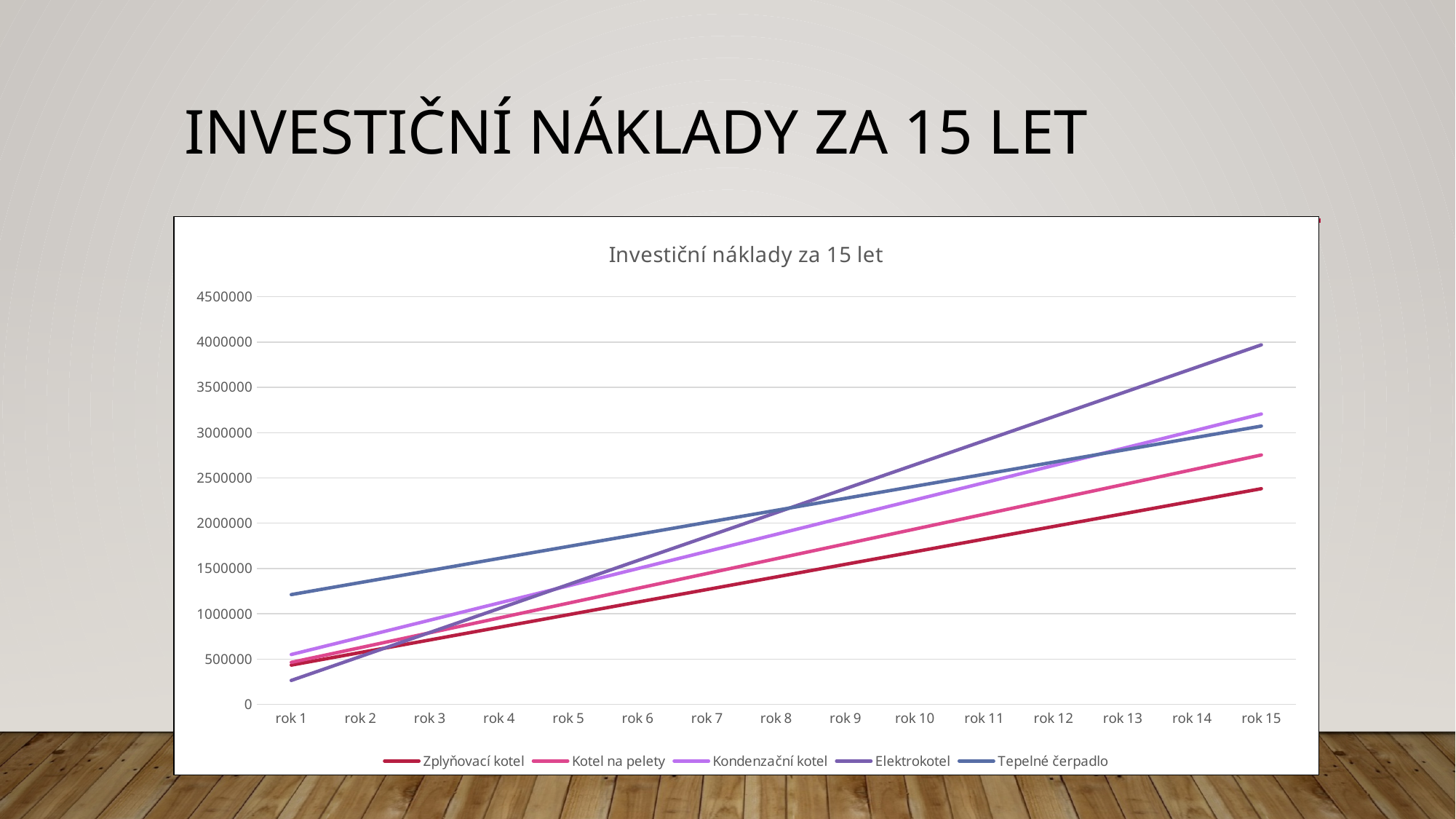
How many categories (years) are shown on the x axis? 15 Is the value for Elektrokotel at rok 15 greater or less than 3500000? greater Is the value for Zplyňovací kotel at rok 15 greater or less than 2500000? less Which series has the lowest value at rok 15? Zplyňovací kotel Which series has the highest value at rok 1? Tepelné čerpadlo At rok 15, which is larger: Kondenzační kotel or Kotel na pelety? Kondenzační kotel What kind of chart is shown on the slide? line chart Do the values for Elektrokotel rise or fall from rok 1 to rok 15? rise What is the title of the chart? Investiční náklady za 15 let Which series has the lowest value at rok 1? Elektrokotel Which series has the highest value at rok 15? Elektrokotel How many series does the legend list? 5